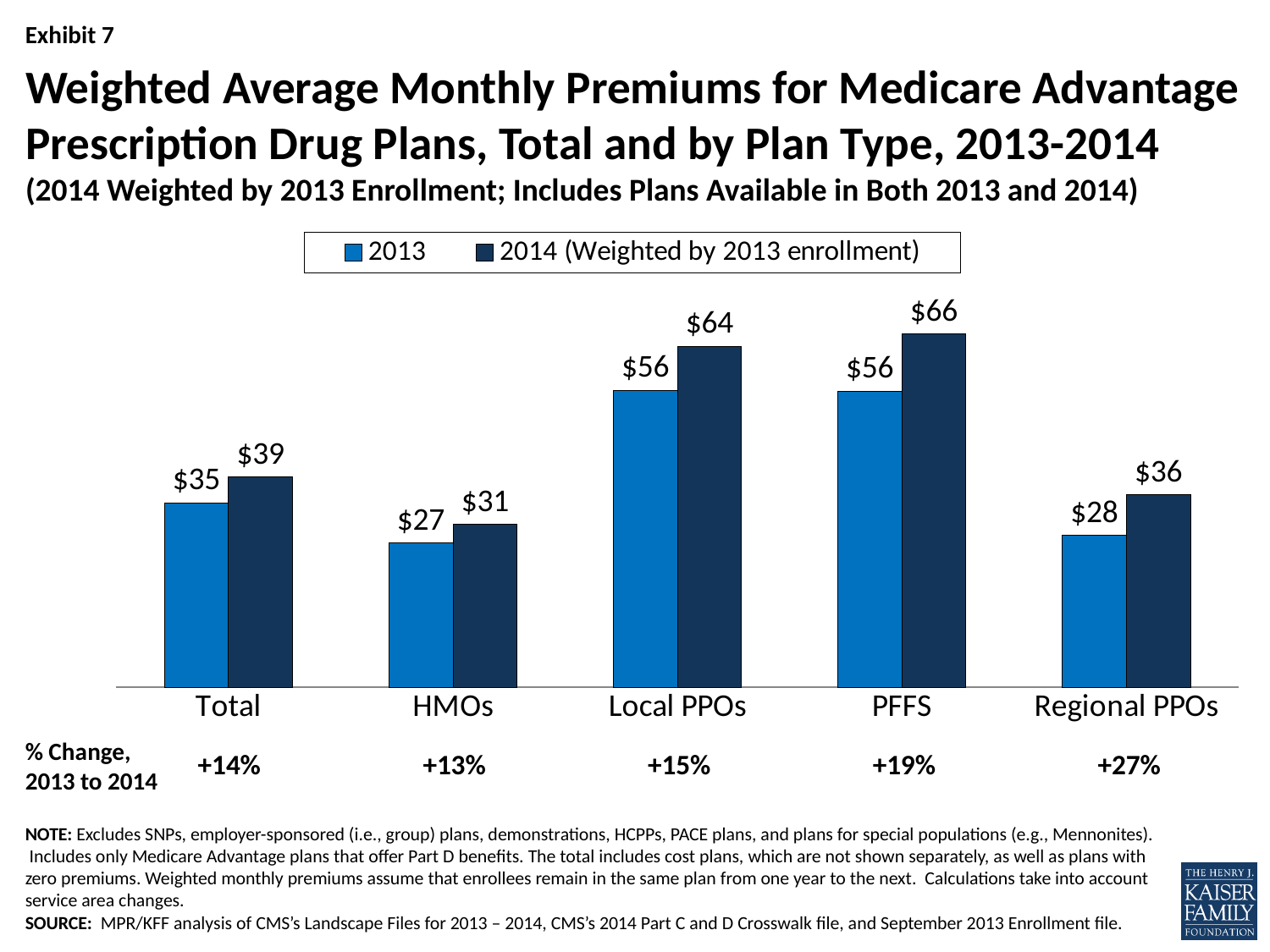
What is the 2013 weighted average monthly premium for HMOs? $27 What is the 2014 (weighted by 2013 enrollment) premium for PFFS plans? $66 How many plan type categories are shown on the x axis? 5 What kind of chart is shown on the slide? Bar chart What is the second legend entry? 2014 (Weighted by 2013 enrollment) Which plan type has the highest 2014 (weighted by 2013 enrollment) premium? PFFS How many series does the legend list? 2 What is the 2014 (weighted by 2013 enrollment) premium for Regional PPOs? $36 Which is larger, the 2013 premium for Total or the 2013 premium for Regional PPOs? Total What is the difference between the 2014 and 2013 premiums for Local PPOs? $8 Which plan type has the lowest 2013 premium? HMOs What is the percent change from 2013 to 2014 shown for Regional PPOs? +27%